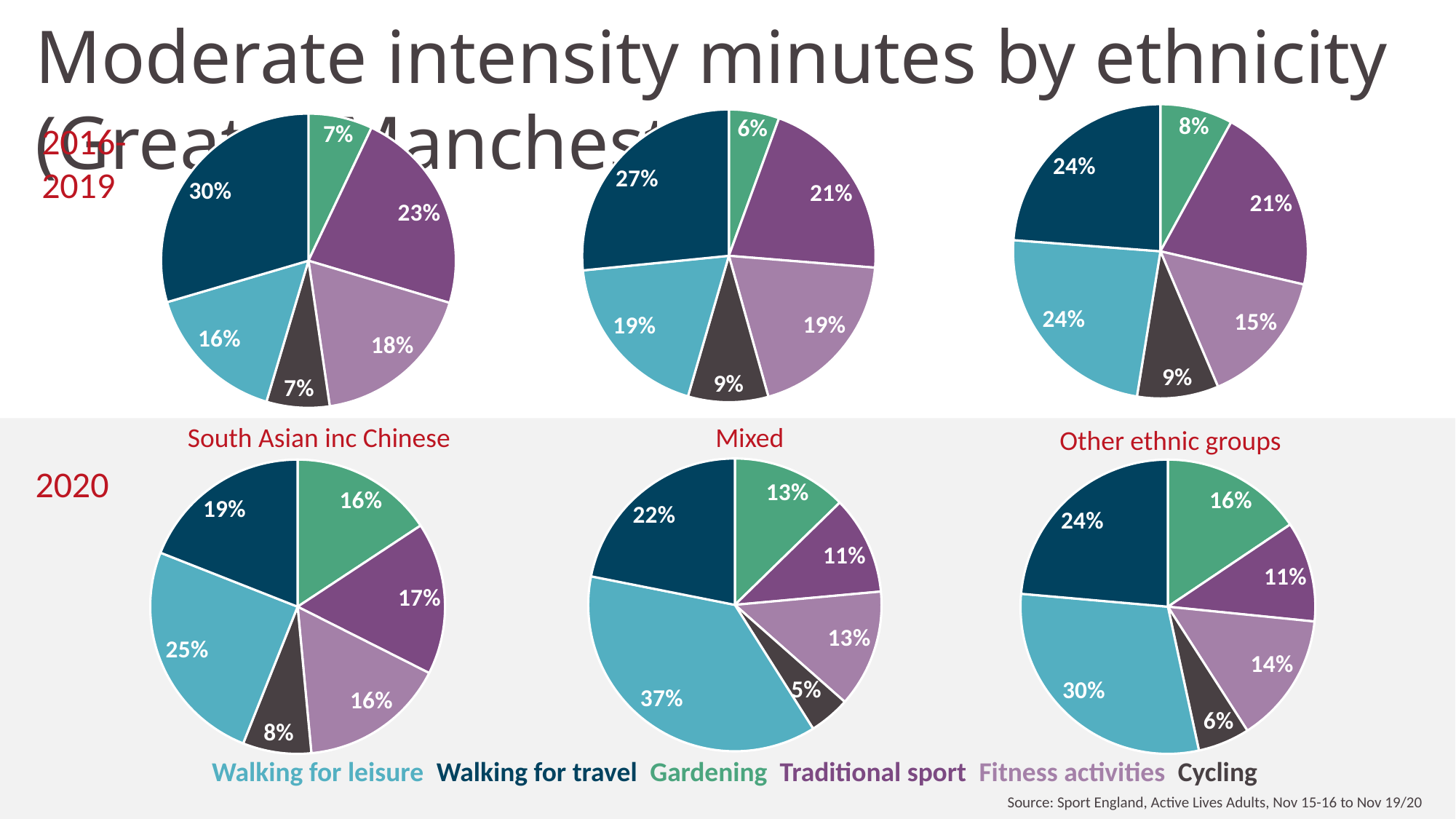
What kind of charts are shown on the slide? Pie charts How many pie charts are on the slide? 6 In the 2016-2019 Mixed pie chart, which activity has the smallest share? Gardening How many activity categories does the legend list? 6 In the 2020 Mixed pie chart, what share is Walking for leisure? 37% Which colour represents Walking for travel in the legend? Dark blue In the 2020 Mixed pie chart, what is the difference between the Walking for leisure share and the Walking for travel share? 15% In the 2016-2019 South Asian inc Chinese pie chart, what share is Walking for travel? 30% In the 2020 South Asian inc Chinese pie chart, which activity has the largest share? Walking for leisure In the 2020 Other ethnic groups pie chart, what share is Cycling? 6% In the 2016-2019 Other ethnic groups pie chart, which is larger: Traditional sport or Fitness activities? Traditional sport